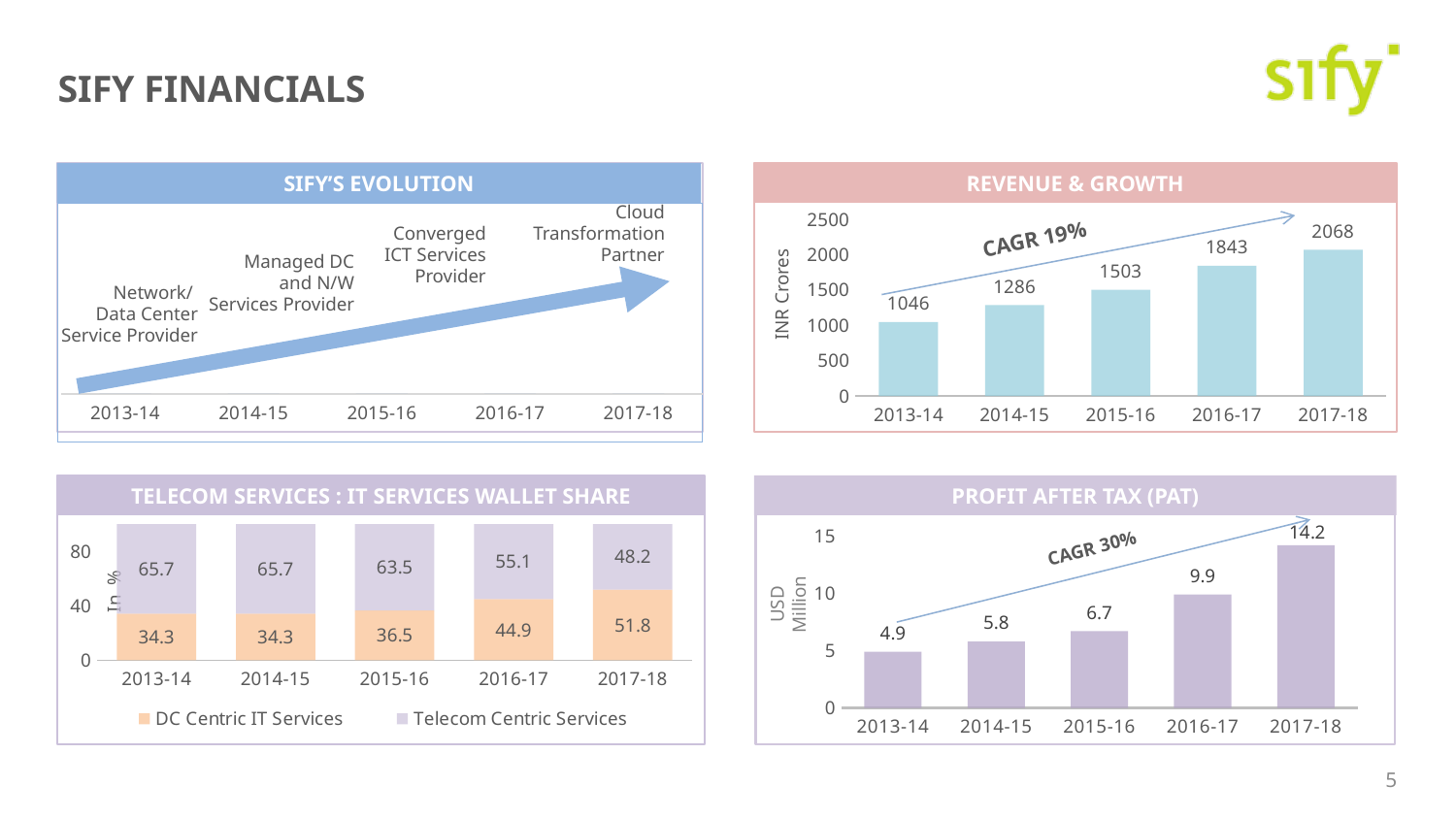
In the Profit After Tax (PAT) chart, how many years are plotted? 5 In the Revenue & Growth chart, what is the difference between the 2016-17 and 2015-16 values? 340 In the Revenue & Growth chart, what is the revenue for 2017-18? 2068 In the Revenue & Growth chart, which year has the lowest revenue? 2013-14 What kind of chart is the Revenue & Growth chart? bar chart In the Telecom Services : IT Services Wallet Share chart, how many series does the legend list? 2 In the Profit After Tax (PAT) chart, what is the value for 2016-17? 9.9 In the Profit After Tax (PAT) chart, which year has the highest value? 2017-18 In the Telecom Services : IT Services Wallet Share chart, what is the value for DC Centric IT Services in 2016-17? 44.9 In the Telecom Services : IT Services Wallet Share chart, which is larger in 2017-18: DC Centric IT Services or Telecom Centric Services? DC Centric IT Services In the Profit After Tax (PAT) chart, what is the difference between the 2017-18 and 2013-14 values? 9.3 In the Revenue & Growth chart, do the values rise or fall from 2013-14 to 2017-18? rise